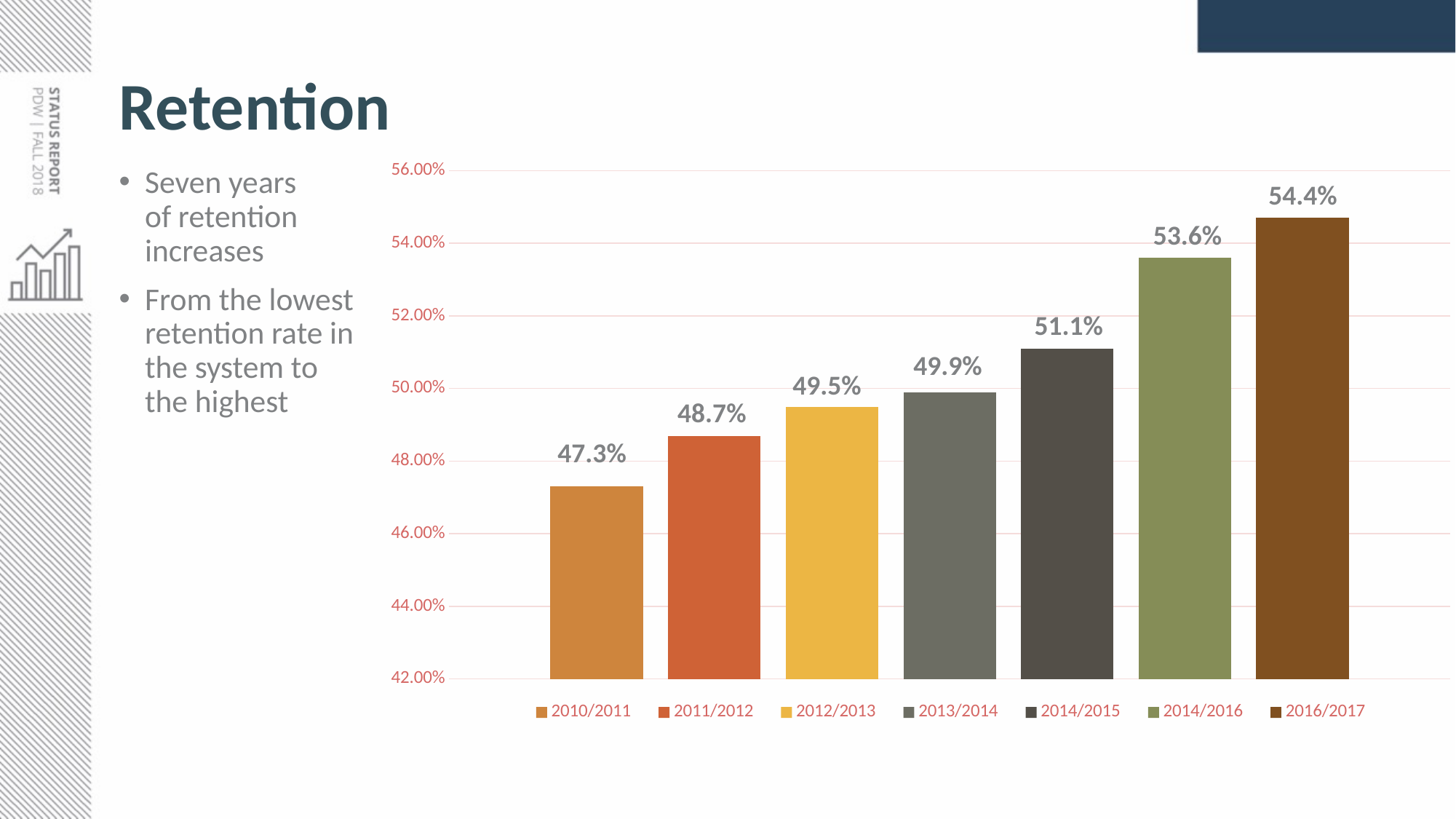
Do the retention rates rise or fall from 2010/2011 to 2016/2017? rise What is the difference between the retention rates for 2016/2017 and 2010/2011? 7.1% Which year has the highest retention rate? 2016/2017 What is the retention rate for 2010/2011? 47.3% What kind of chart is shown on the slide? bar chart Which year has the lowest retention rate? 2010/2011 Which is larger, the retention rate for 2012/2013 or for 2011/2012? 2012/2013 Is the retention rate for 2013/2014 greater or less than 50.00%? less How many years are shown in the chart? 7 What is the retention rate for 2016/2017? 54.4% What is the difference between the retention rates for 2014/2016 and 2013/2014? 3.7% What is the retention rate for 2014/2015? 51.1%